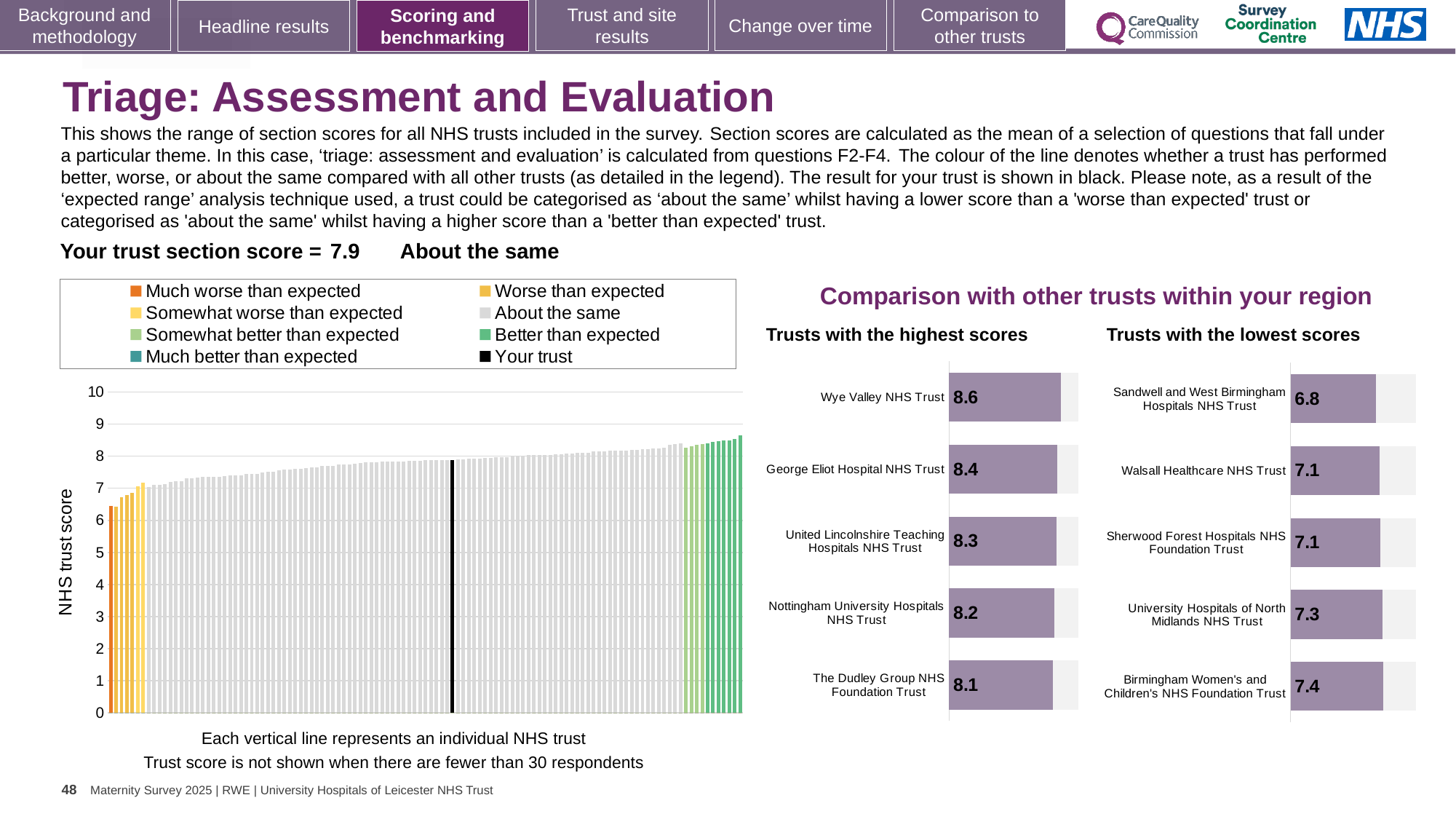
In the 'Trusts with the highest scores' chart, what is the difference between the scores of Wye Valley NHS Trust and The Dudley Group NHS Foundation Trust? 0.5 In the 'Trusts with the lowest scores' chart, which trust has the lowest score? Sandwell and West Birmingham Hospitals NHS Trust In the 'Trusts with the highest scores' chart, what is the score for Wye Valley NHS Trust? 8.6 In the left-hand chart, is the value of the lowest bar greater or less than 7? less In the left-hand chart, what is the section score for your trust (the black bar)? 7.9 What is the y-axis label of the left-hand chart? NHS trust score What kind of chart is the large chart on the left showing all NHS trusts? bar chart How many entries does the legend above the left-hand chart list? 8 In the 'Trusts with the lowest scores' chart, what is the score for Sandwell and West Birmingham Hospitals NHS Trust? 6.8 In the 'Trusts with the highest scores' chart, which trust has the highest score? Wye Valley NHS Trust In the 'Trusts with the lowest scores' chart, which has the larger score: Walsall Healthcare NHS Trust or University Hospitals of North Midlands NHS Trust? University Hospitals of North Midlands NHS Trust How many trusts are shown in the 'Trusts with the highest scores' chart? 5